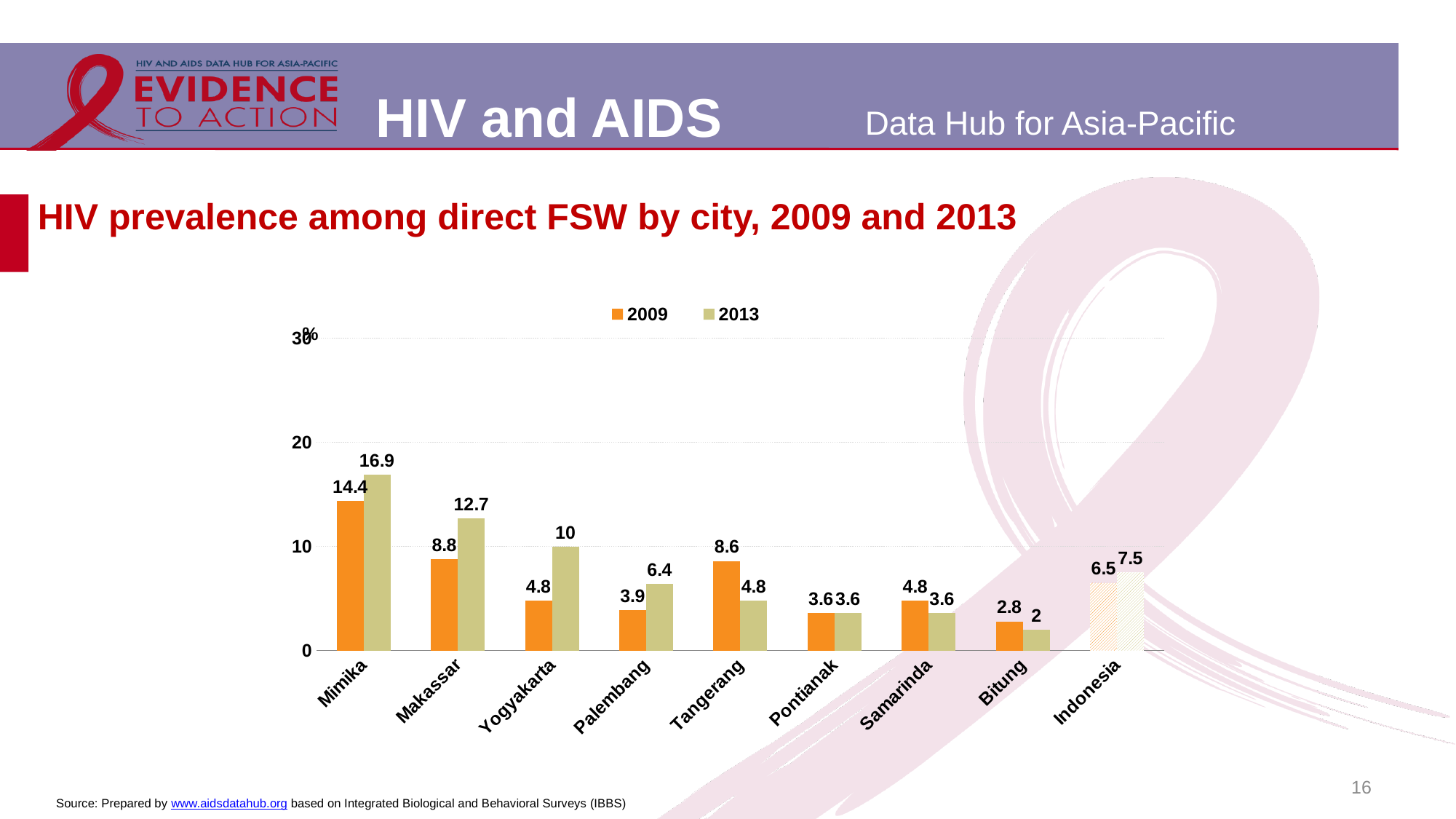
What is the 2009 HIV prevalence value for Mimika? 14.4 What kind of chart is shown on the slide? Bar chart What is the 2013 value for Indonesia? 7.5 How many series does the legend list? 2 What is the 2013 HIV prevalence value for Makassar? 12.7 How many cities or categories are shown on the x axis? 9 What is the 2009 value for Tangerang? 8.6 Which is larger for Tangerang, the 2009 value or the 2013 value? 2009 What is the 2013 value for Yogyakarta? 10 Which city has the lowest 2013 value? Bitung Which city has the highest 2013 value? Mimika What is the difference between the 2013 and 2009 values for Mimika? 2.5